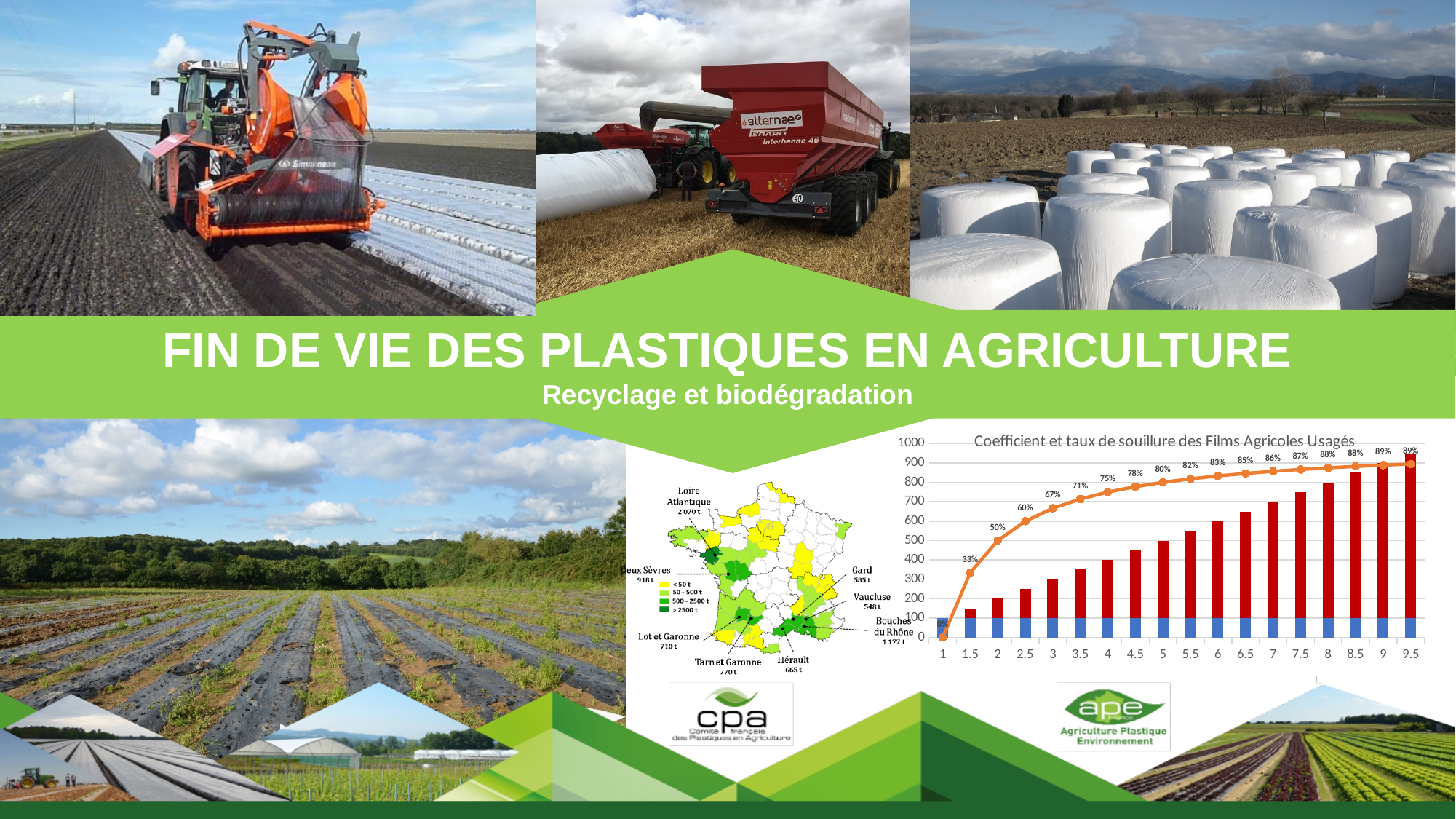
In the chart 'Coefficient et taux de souillure des Films Agricoles Usagés', what is the difference between the line percentages at x = 3 and x = 2? 17 percentage points In the chart 'Coefficient et taux de souillure des Films Agricoles Usagés', what percentage is labelled on the line at x = 9.5? 89% In the chart 'Coefficient et taux de souillure des Films Agricoles Usagés', how many x-axis categories are plotted? 18 In the chart 'Coefficient et taux de souillure des Films Agricoles Usagés', at which x value is the line percentage lowest? 1 What kind of chart is 'Coefficient et taux de souillure des Films Agricoles Usagés'? combination stacked bar and line chart In the chart 'Coefficient et taux de souillure des Films Agricoles Usagés', is the total height of the stacked bar at x = 1.5 greater or less than 200? less In the chart 'Coefficient et taux de souillure des Films Agricoles Usagés', is the line percentage at x = 3 or at x = 4 larger? 4 In the chart 'Coefficient et taux de souillure des Films Agricoles Usagés', is the total height of the stacked bar at x = 9.5 greater or less than 800? greater In the chart 'Coefficient et taux de souillure des Films Agricoles Usagés', does the line rise or fall as x increases? rise In the chart 'Coefficient et taux de souillure des Films Agricoles Usagés', what percentage is labelled on the line at x = 2? 50% What is the title of the chart on the right of the slide? Coefficient et taux de souillure des Films Agricoles Usagés In the chart 'Coefficient et taux de souillure des Films Agricoles Usagés', what percentage is labelled on the line at x = 4? 75%